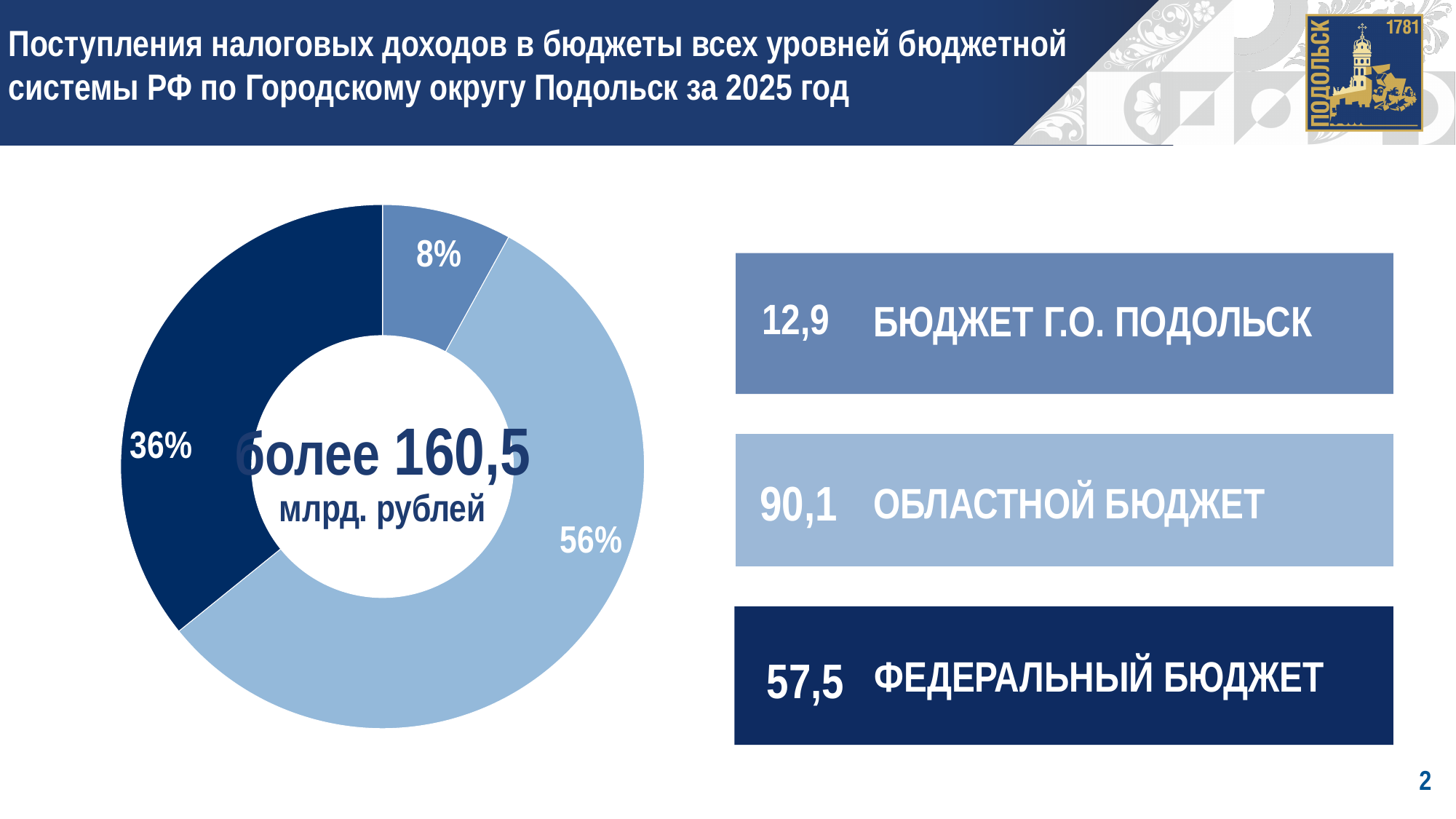
What value in billions of rubles is shown for Областной бюджет? 90,1 What value in billions of rubles is shown for Бюджет Г.О. Подольск? 12,9 Which budget has the smallest slice in the pie chart? Бюджет Г.О. Подольск Which is larger: the share for Федеральный бюджет or the share for Бюджет Г.О. Подольск? Федеральный бюджет What share of the pie does the Бюджет Г.О. Подольск slice represent? 8% What share of the pie does the Федеральный бюджет slice represent? 36% Which budget has the largest slice in the pie chart? Областной бюджет What share of the pie does the Областной бюджет slice represent? 56% What total amount is shown in the centre of the donut chart? более 160,5 млрд. рублей What value in billions of rubles is shown for Федеральный бюджет? 57,5 What kind of chart is shown on the slide? Pie chart (donut) How many slices does the pie chart have? 3